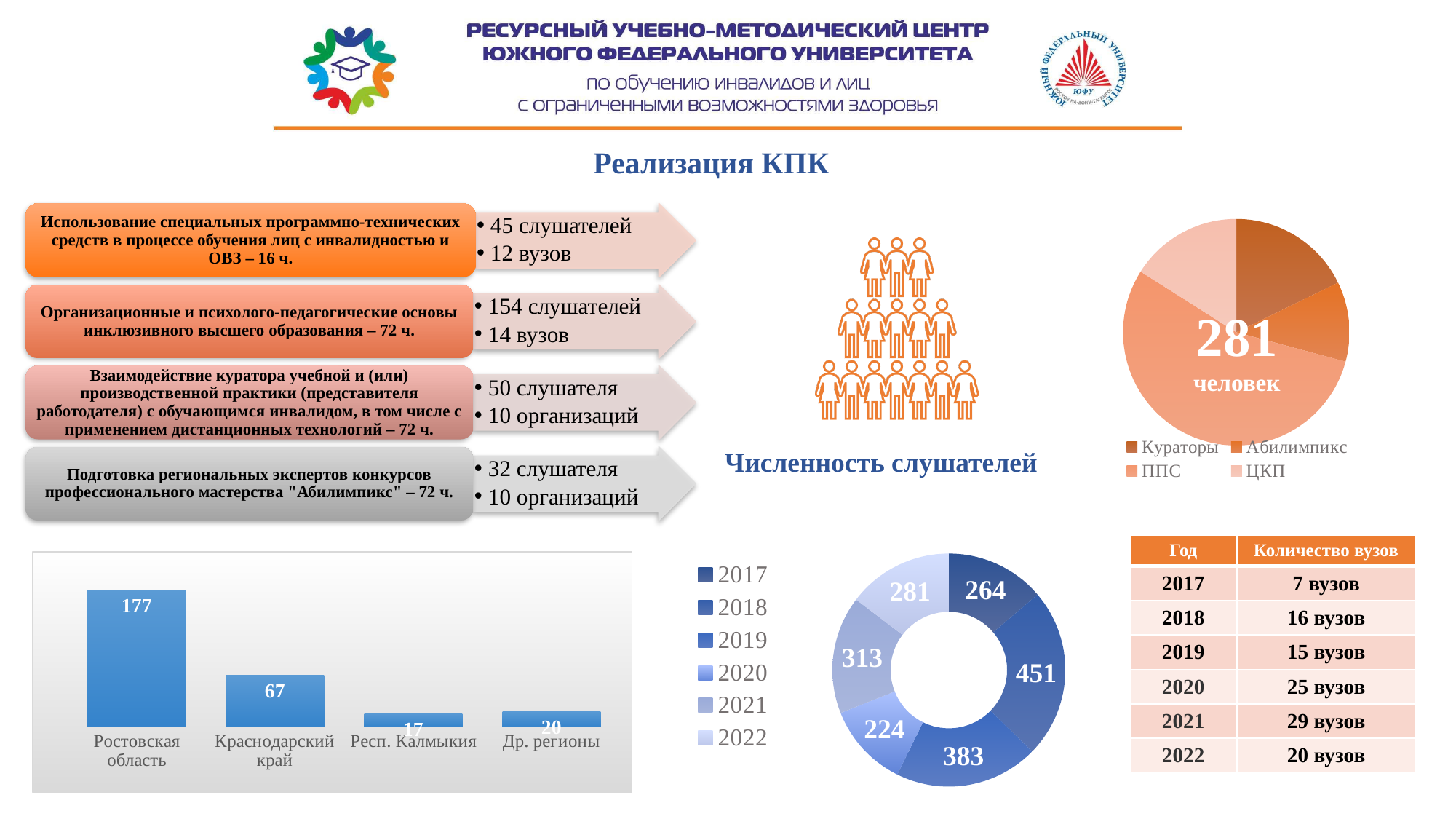
In the bar chart at the bottom left, what is the value for Краснодарский край? 67 In the donut chart at the bottom middle, which year has the highest value? 2018 In the donut chart at the bottom middle, how many years does the legend list? 6 In the bar chart at the bottom left, what is the difference between Ростовская область and Краснодарский край? 110 In the pie chart at the top right, how many entries does the legend list? 4 In the bar chart at the bottom left, what is the value for Ростовская область? 177 In the bar chart at the bottom left, which is larger: Респ. Калмыкия or Др. регионы? Др. регионы In the donut chart at the bottom middle, what is the value for 2018? 451 In the pie chart at the top right, which category has the largest slice? ППС In the donut chart at the bottom middle, what is the value for 2020? 224 In the bar chart at the bottom left, how many categories are shown? 4 In the bar chart at the bottom left, which category has the lowest value? Респ. Калмыкия